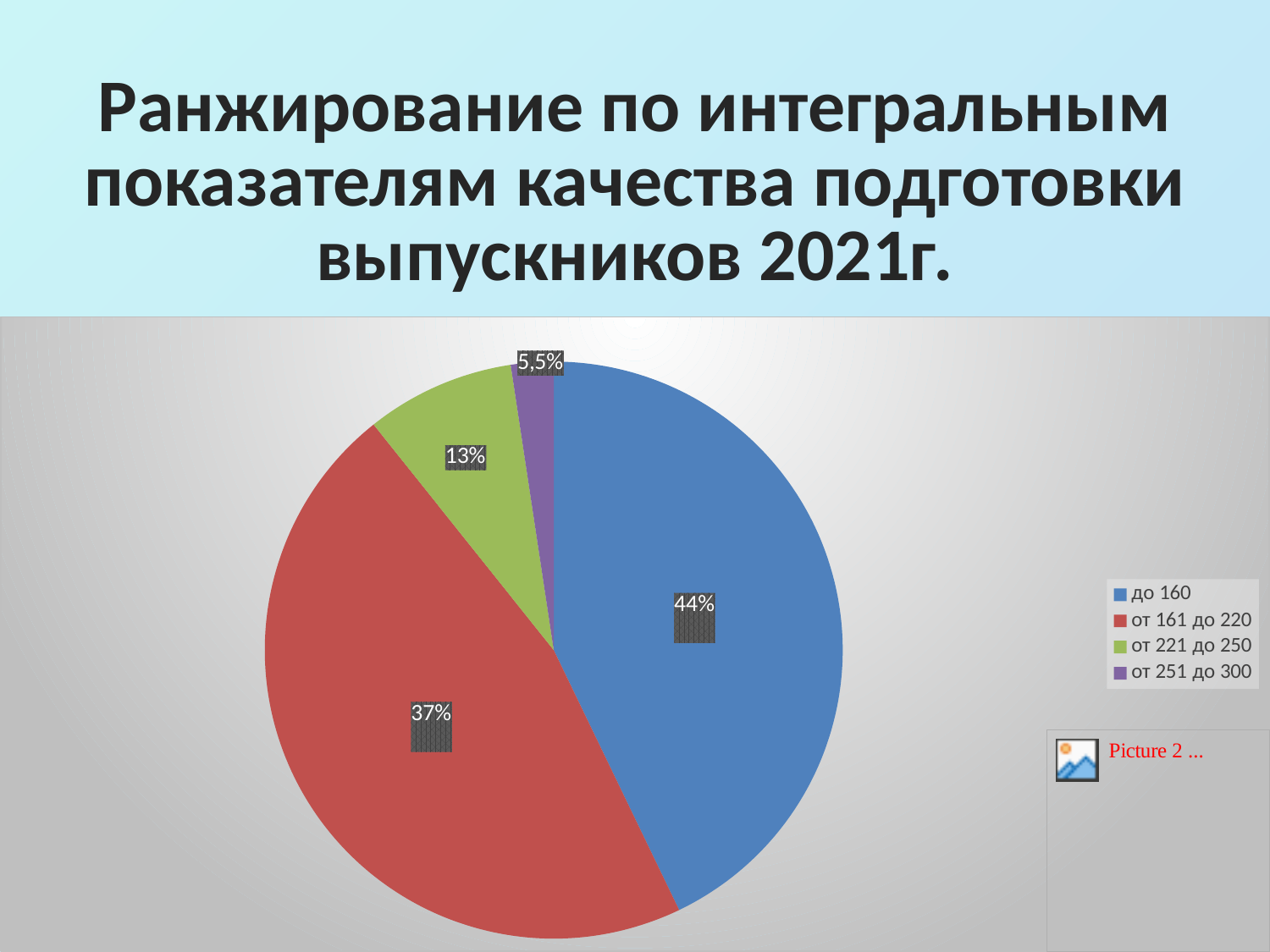
What kind of chart is shown on the slide? pie chart What share of the pie does the "от 251 до 300" slice have? 5,5% What colour is the slice for "от 221 до 250"? green What share of the pie does the "от 221 до 250" slice have? 13% What share of the pie does the "от 161 до 220" slice have? 37% What is the difference in percentage points between the "до 160" slice and the "от 161 до 220" slice? 7 How many entries does the legend list? 4 How many slices does the pie chart have? 4 Which is larger: the share for "от 161 до 220" or the share for "от 221 до 250"? от 161 до 220 Which category has the smallest slice of the pie? от 251 до 300 Which category has the largest slice of the pie? от 161 до 220